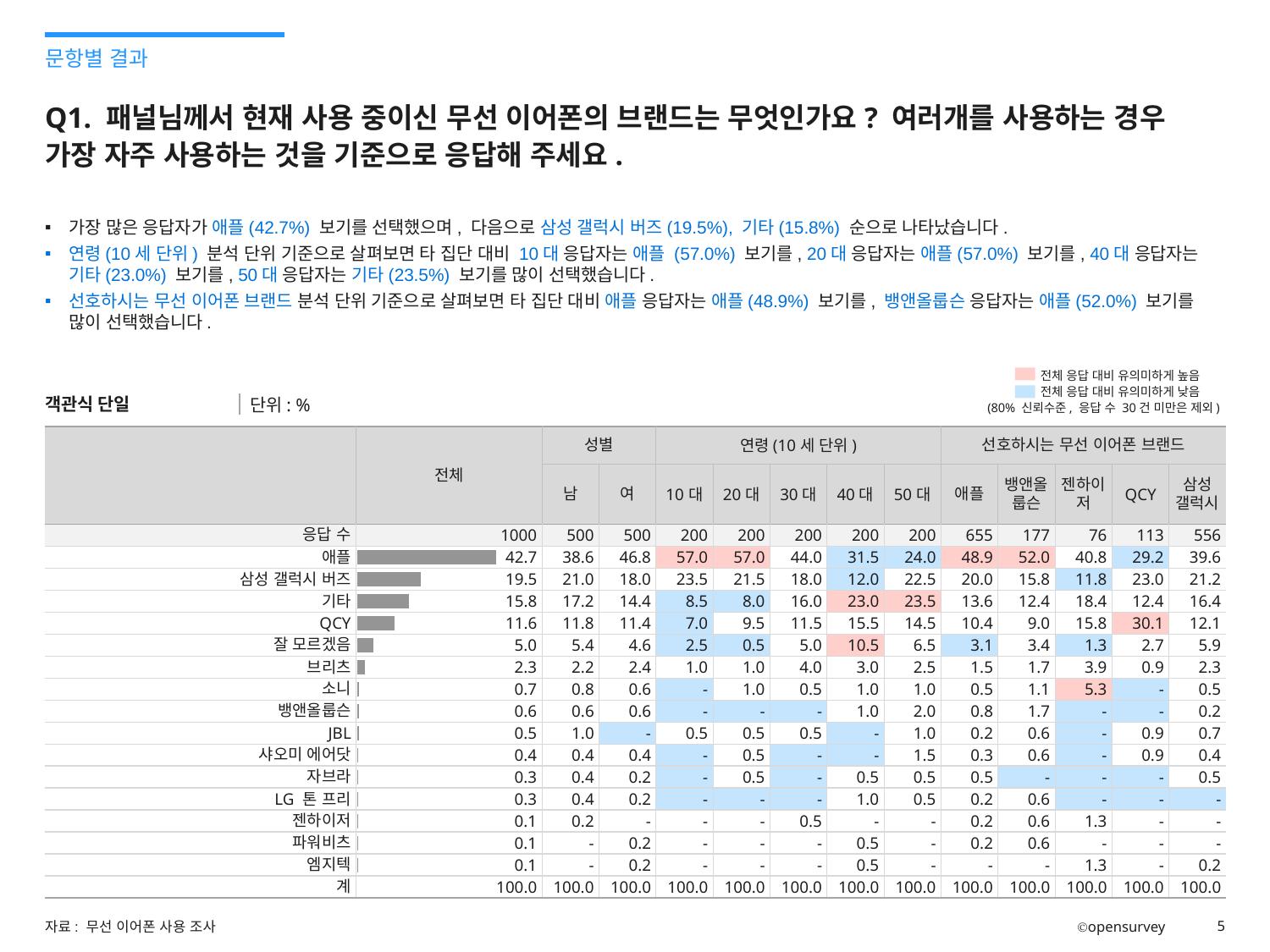
In the bar chart of the 전체 column, what is the value for 삼성 갤럭시 버즈? 19.5 In the bar chart of the 전체 column, what is the value for 애플? 42.7 In the bar chart of the 전체 column, what is the value for 잘 모르겠음? 5.0 What unit is stated for the values in the chart and table? % In the bar chart of the 전체 column, which is larger, 기타 or QCY? 기타 How many brand categories (excluding 응답 수 and 계) are shown in the bar chart of the 전체 column? 15 In the bar chart of the 전체 column, which is larger, 브리츠 or 잘 모르겠음? 잘 모르겠음 In the bar chart of the 전체 column, what is the difference between 애플 and 삼성 갤럭시 버즈? 23.2 What is the total number of respondents (응답 수) for 전체? 1000 In the bar chart of the 전체 column, what is the difference between 기타 and QCY? 4.2 In the bar chart of the 전체 column, which brand has the highest value? 애플 What kind of chart is embedded in the 전체 column of the table? bar chart